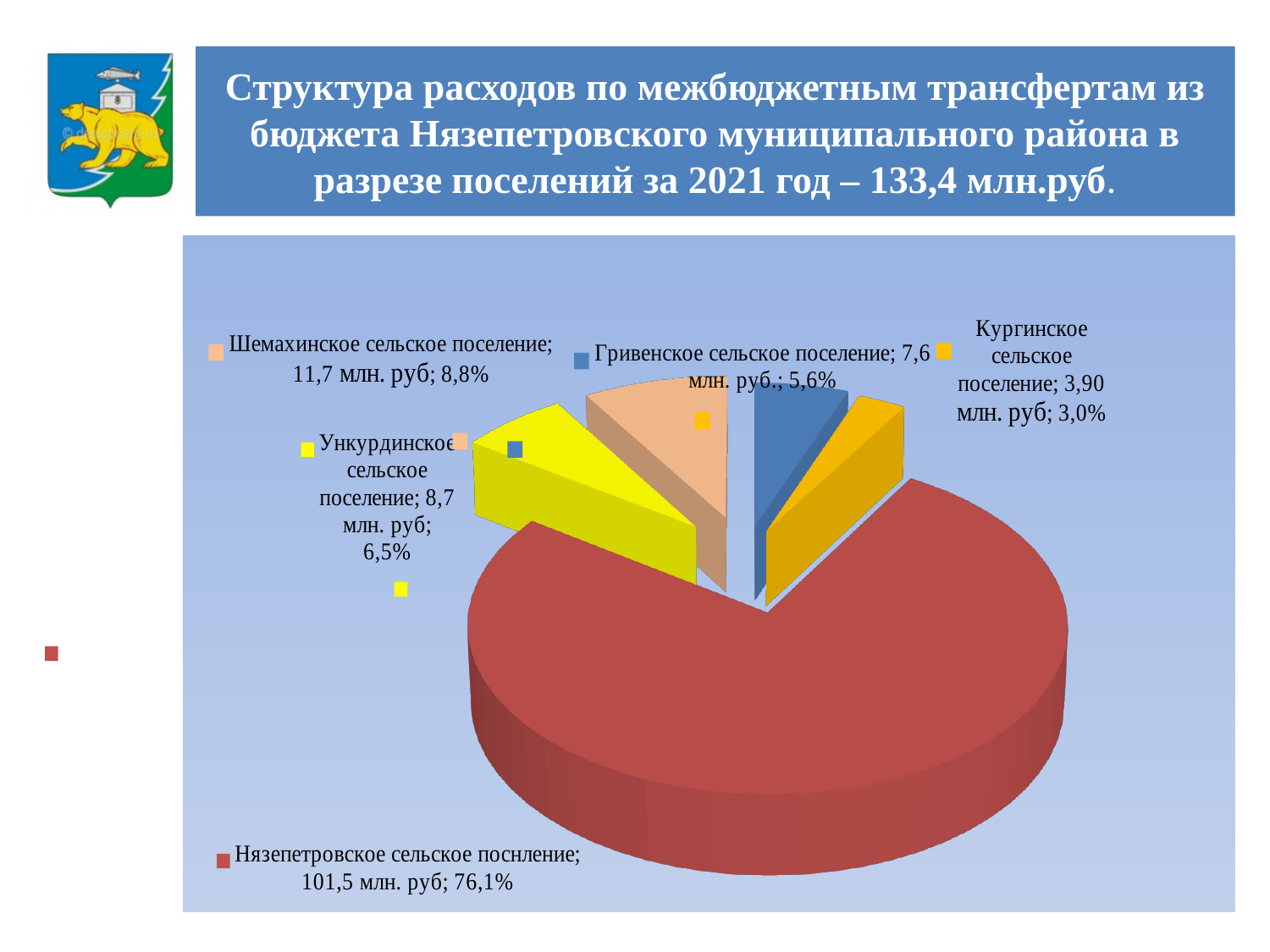
How many slices does the pie chart have? 5 What is the difference in млн. руб between Шемахинское сельское поселение and Ункурдинское сельское поселение? 3,0 млн. руб What share of the pie does Ункурдинское сельское поселение have? 6,5% What is the value for Нязепетровское сельское поселение? 101,5 млн. руб Which settlement has the smallest slice of the pie? Кургинское сельское поселение What kind of chart is shown on the slide? pie chart What is the value for Шемахинское сельское поселение? 11,7 млн. руб What share of the pie does Кургинское сельское поселение have? 3,0% Which is larger, the value for Гривенское сельское поселение or Кургинское сельское поселение? Гривенское сельское поселение What share of the pie does Нязепетровское сельское поселение have? 76,1% What is the value for Гривенское сельское поселение? 7,6 млн. руб. Which settlement has the largest slice of the pie? Нязепетровское сельское поселение